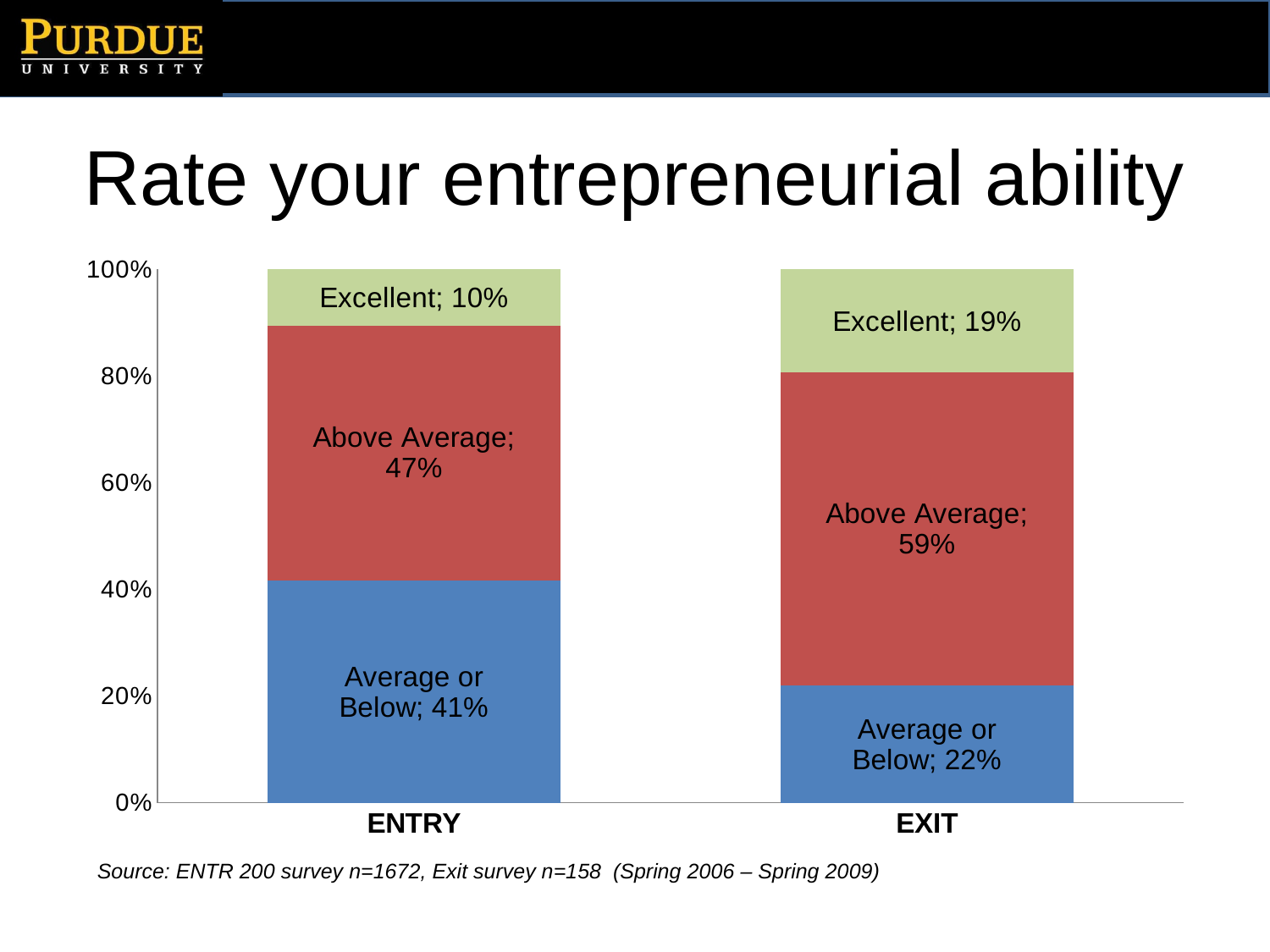
How many bars (categories) are shown on the x axis? 2 Which category has the largest share in the ENTRY bar? Above Average Is the Average or Below share larger for ENTRY or for EXIT? ENTRY What is the Average or Below share for the EXIT bar? 22% How many segments make up each stacked bar? 3 Which category has the smallest share in the EXIT bar? Excellent What percentage of EXIT respondents rated their entrepreneurial ability as Above Average? 59% By how many percentage points does the Excellent share differ between EXIT and ENTRY? 9% What is the title of the slide? Rate your entrepreneurial ability What kind of chart is shown on the slide? Stacked bar chart What is the Above Average share for the ENTRY bar? 47% What percentage of ENTRY respondents rated their entrepreneurial ability as Excellent? 10%